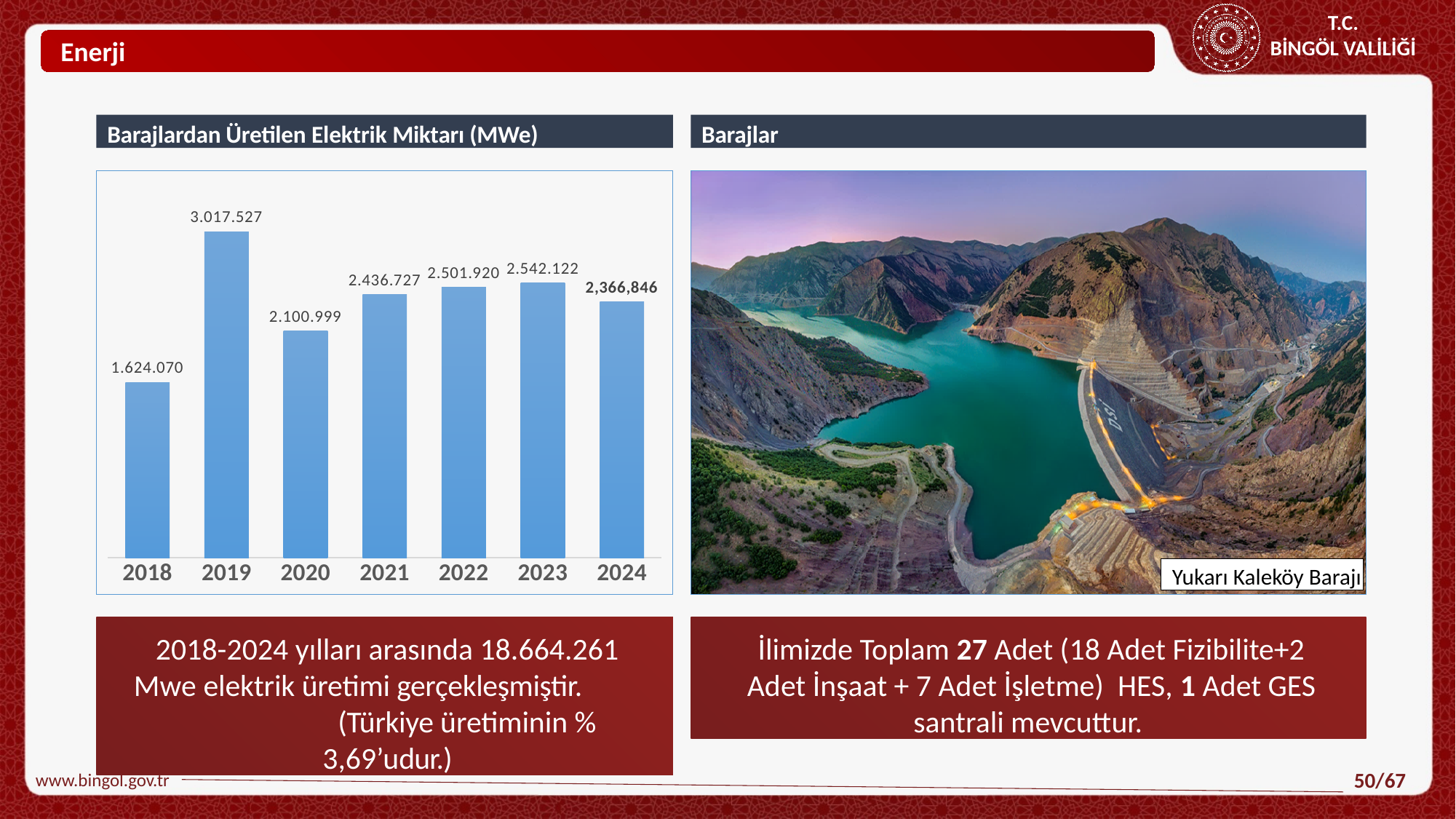
Which year has the larger value in the bar chart, 2020 or 2022? 2022 What is the difference between the values for 2023 and 2022 in the bar chart? 40.202 What is the value shown for 2018 in the bar chart? 1.624.070 What is the value shown for 2019 in the bar chart? 3.017.527 How many years are shown on the x axis of the bar chart? 7 What is the title of the bar chart on the left of the slide? Barajlardan Üretilen Elektrik Miktarı (MWe) What is the value shown for 2021 in the bar chart? 2.436.727 Do the values in the bar chart rise or fall from 2020 to 2023? rise Which year has the highest value in the bar chart? 2019 What is the value shown for 2024 in the bar chart? 2,366,846 What type of chart is shown under the title "Barajlardan Üretilen Elektrik Miktarı (MWe)"? bar chart Which year has the lowest value in the bar chart? 2018